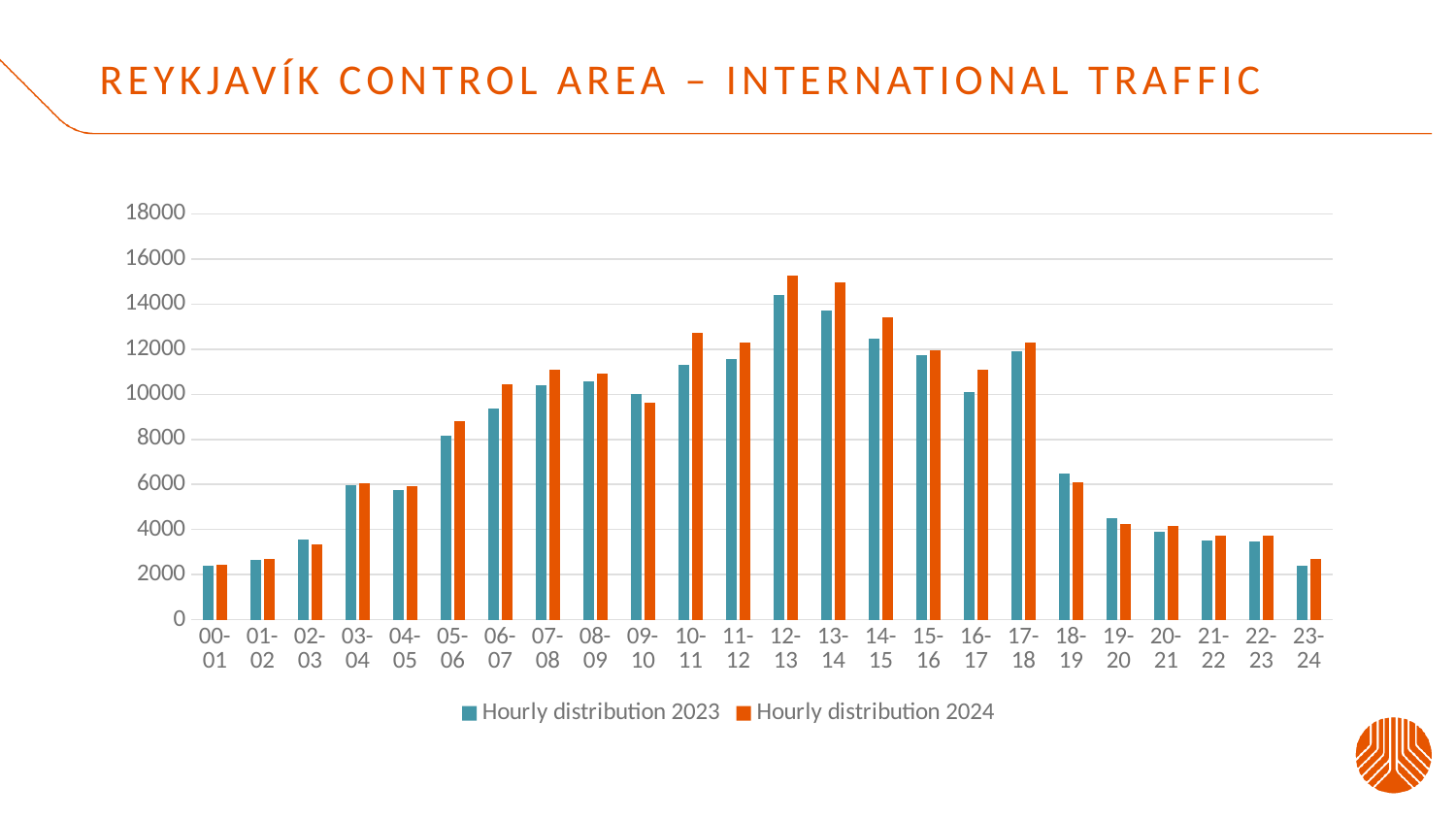
At 18-19, which series has the larger value, Hourly distribution 2023 or Hourly distribution 2024? Hourly distribution 2023 Do the values for Hourly distribution 2024 rise or fall from 00-01 to 12-13? rise Is the value for Hourly distribution 2024 at 12-13 greater or less than 14000? greater How many series does the legend list? 2 At 10-11, which series has the larger value, Hourly distribution 2023 or Hourly distribution 2024? Hourly distribution 2024 Is the value for Hourly distribution 2024 at 13-14 greater or less than 14000? greater Is the value for Hourly distribution 2023 at 06-07 greater or less than 10000? less Which hour has the highest value for Hourly distribution 2023? 12-13 What are the two entries in the chart legend? Hourly distribution 2023 and Hourly distribution 2024 Which hour has the highest value for Hourly distribution 2024? 12-13 What kind of chart is shown on the slide? bar chart How many hourly categories are shown on the x axis? 24